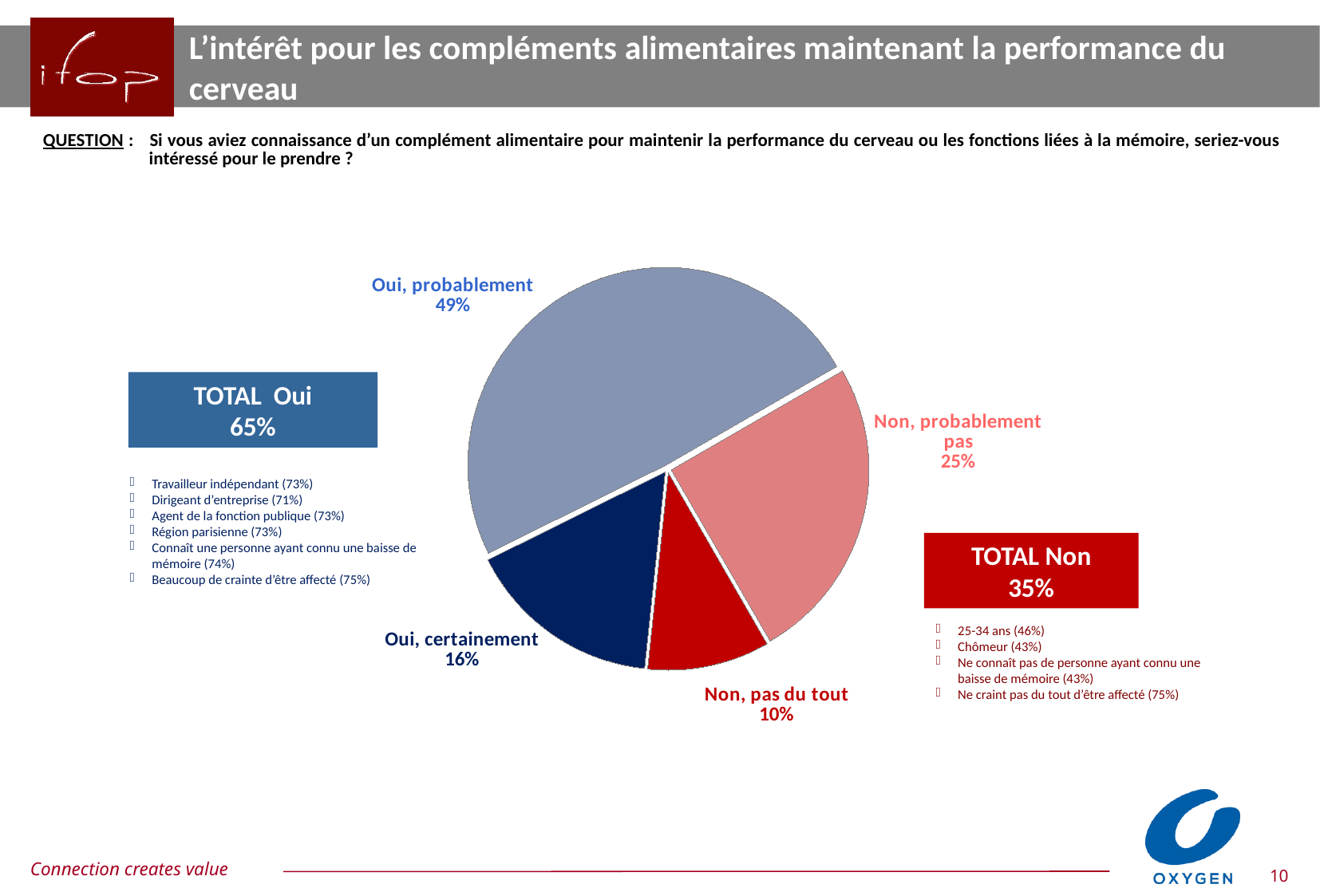
What is the difference between "Oui, probablement" and "Non, probablement pas"? 24 percentage points Which slice of the pie is the smallest? Non, pas du tout What colour is the "Non, pas du tout" slice? red How many slices does the pie chart have? 4 What is the value for "Non, probablement pas"? 25% What is the value for "Non, pas du tout"? 10% What kind of chart is shown on the slide? pie chart What is the value for "Oui, certainement"? 16% What is the value for "Oui, probablement"? 49% What is the combined share of the two "Oui" slices ("Oui, probablement" and "Oui, certainement")? 65% Which is larger, "Oui, certainement" or "Non, pas du tout"? Oui, certainement Which slice of the pie is the largest? Oui, probablement